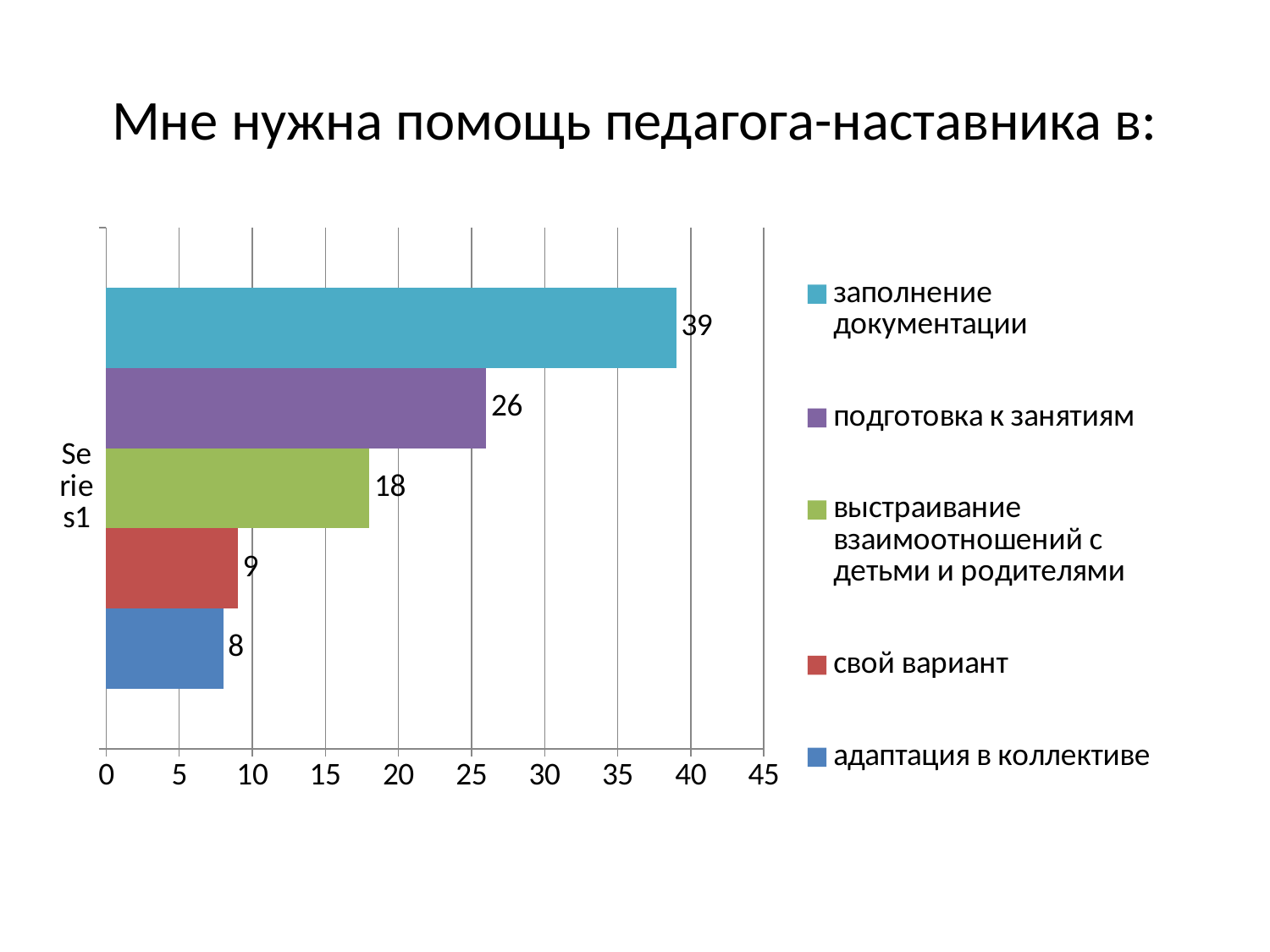
How many bars are plotted in the chart? 5 What is the difference between the values for заполнение документации and подготовка к занятиям? 13 What kind of chart is shown on the slide? bar chart What is the value for выстраивание взаимоотношений с детьми и родителями? 18 Which is larger, the value for свой вариант or the value for адаптация в коллективе? свой вариант What is the value for подготовка к занятиям? 26 What is the value for заполнение документации? 39 Which category has the lowest value? адаптация в коллективе What is the value for адаптация в коллективе? 8 Is the value for подготовка к занятиям greater or less than 25? greater Which category has the highest value? заполнение документации What is the title of the chart? Мне нужна помощь педагога-наставника в: